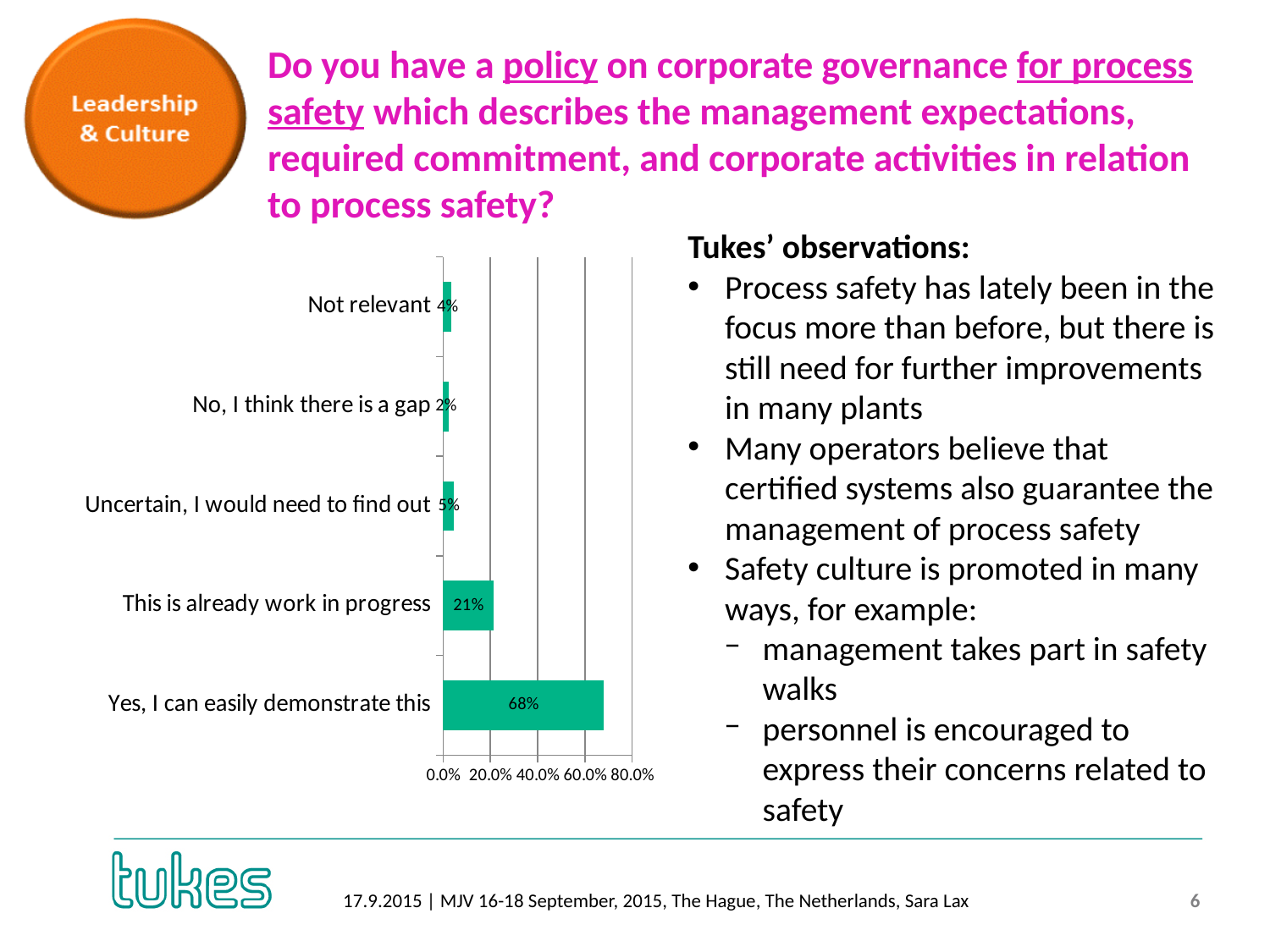
How many response categories are shown in the chart? 5 Which response category has the lowest percentage? No, I think there is a gap What type of chart is shown on the slide? Bar chart What percentage of respondents answered "No, I think there is a gap"? 2% Which response category has the highest percentage? Yes, I can easily demonstrate this What percentage of respondents answered "This is already work in progress"? 21% What percentage of respondents answered "Yes, I can easily demonstrate this"? 68% What percentage of respondents answered "Not relevant"? 4% What percentage of respondents answered "Uncertain, I would need to find out"? 5% Which is larger: the percentage for "Not relevant" or for "Uncertain, I would need to find out"? Uncertain, I would need to find out What is the difference in percentage points between "Yes, I can easily demonstrate this" and "This is already work in progress"? 47 Is the value for "Yes, I can easily demonstrate this" greater or less than 60.0%? greater